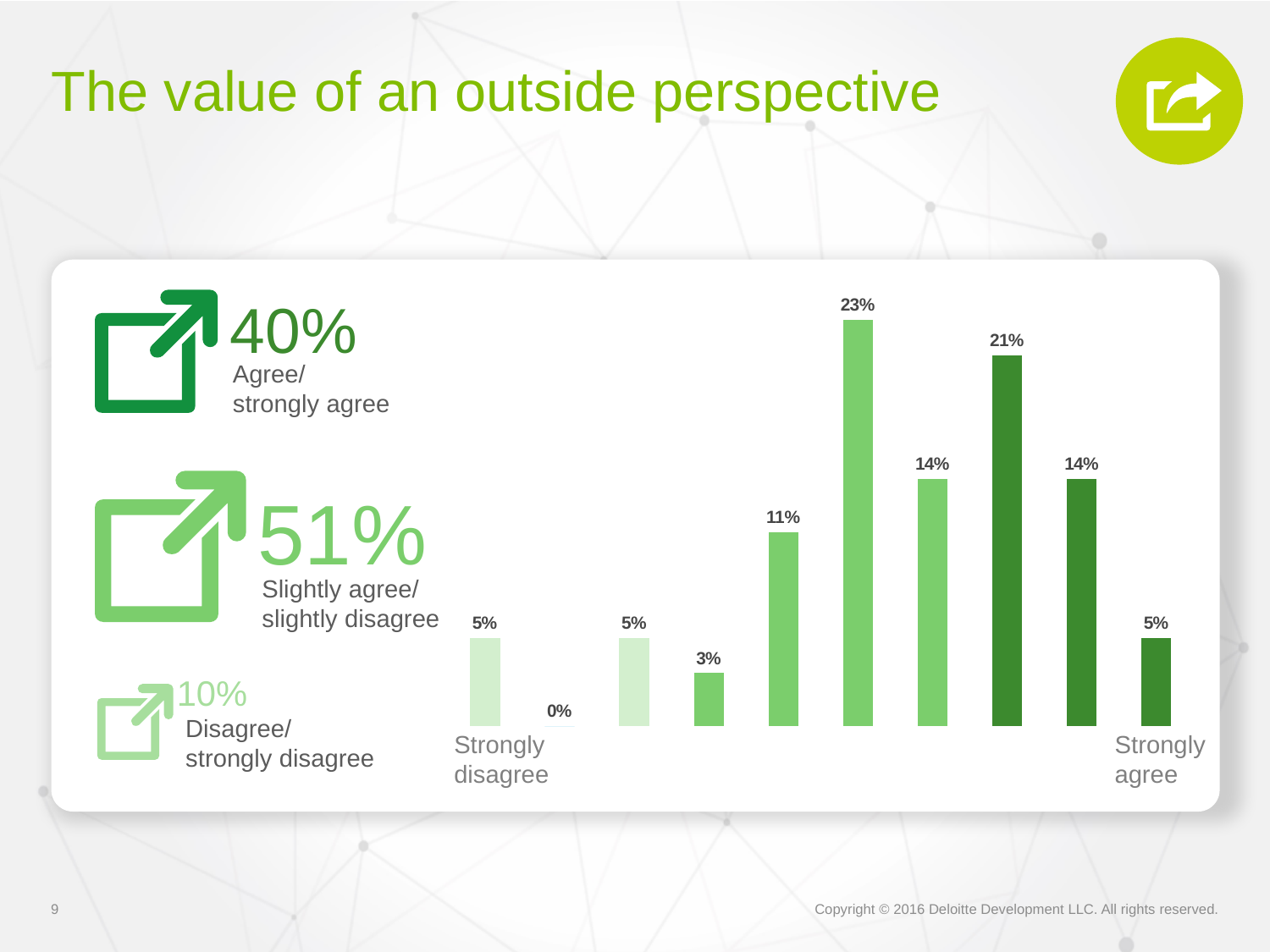
What kind of chart is shown on the slide? bar chart What is the title of the slide containing the chart? The value of an outside perspective What is the value of the second bar from the left in the chart? 0% What is the value of the bar labelled "Strongly disagree" at the left end of the chart? 5% How many bars are plotted in the chart? 10 What is the value of the fourth bar from the left in the chart? 3% Which is larger, the 11% bar or the 21% bar? the 21% bar What is the value of the bar labelled "Strongly agree" at the right end of the chart? 5% What is the difference between the highest bar (23%) and the 21% bar? 2% What is the lowest value shown in the chart? 0% What is the total of the two bars labelled 14%? 28% What is the highest value shown in the chart? 23%